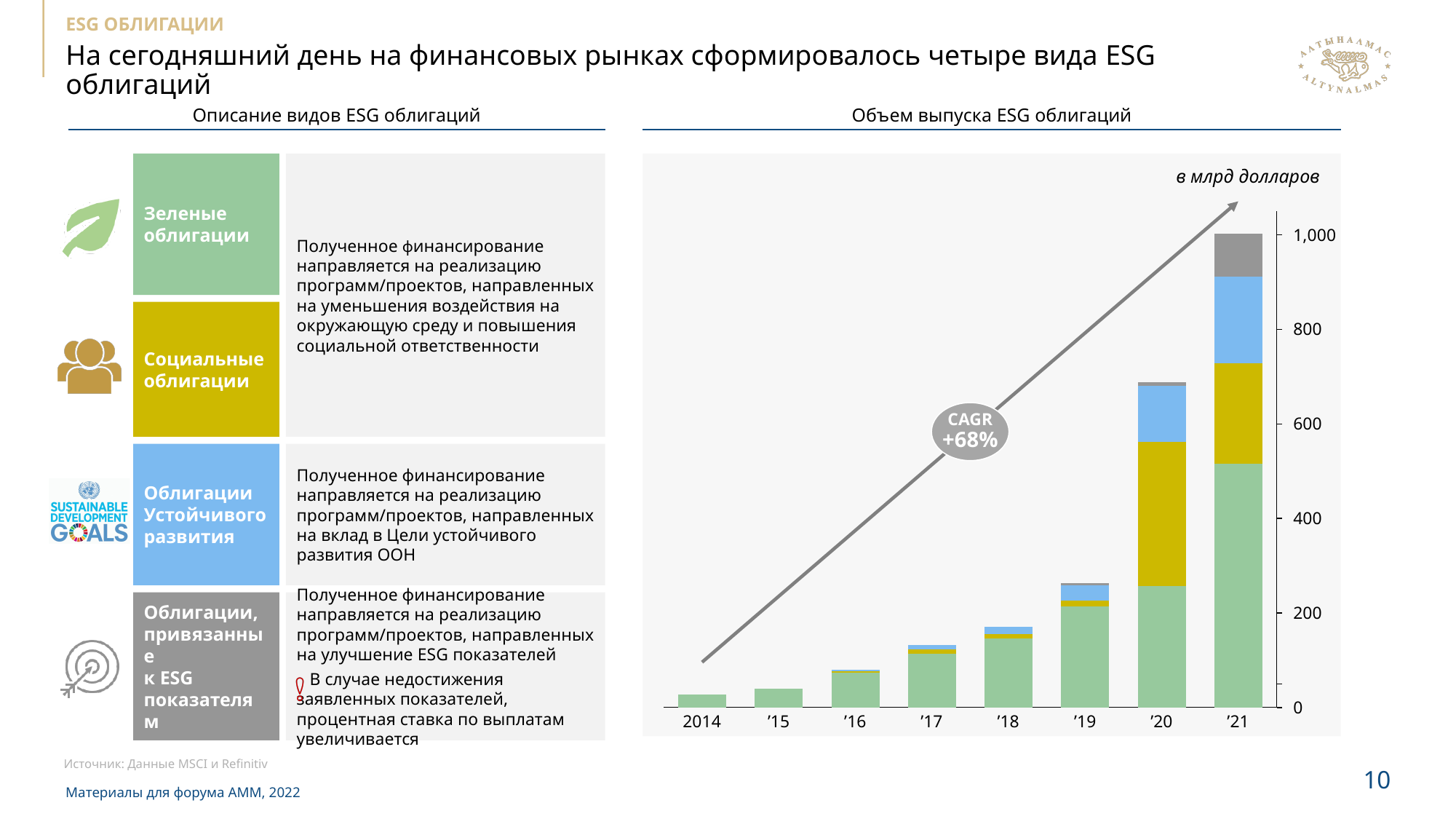
In what units are the values of the ESG bond issuance chart expressed? в млрд долларов Which year has the lowest total ESG bond issuance volume in the chart? 2014 Is the total ESG bond issuance for '21 greater or less than 800? greater Is the total ESG bond issuance for '20 greater or less than 600? greater Is the total ESG bond issuance for '18 greater or less than 200? less Which year has the highest total ESG bond issuance volume in the chart? '21 How many years are shown on the x axis of the ESG bond issuance chart? 8 Which year has a larger total ESG bond issuance, '19 or '20? '20 What kind of chart is shown under "Объем выпуска ESG облигаций"? Stacked bar chart What CAGR value is annotated on the ESG bond issuance chart? +68% Do the total bar heights in the ESG bond issuance chart rise or fall from 2014 to '21? Rise